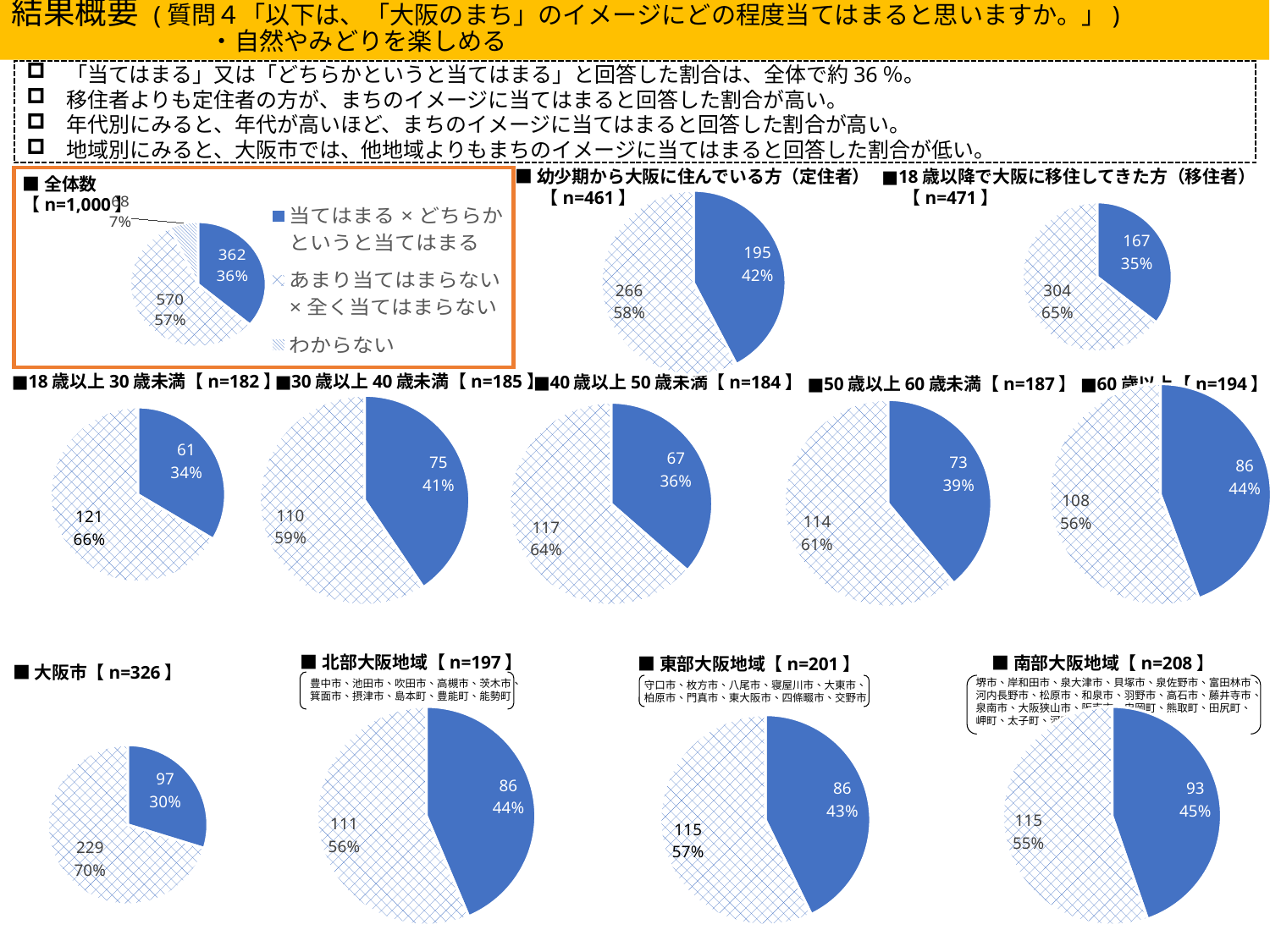
How many entries does the legend next to the 全体数 pie chart list? 3 In the 全体数 (n=1,000) pie chart, how many respondents answered あまり当てはまらない × 全く当てはまらない? 570 In the 幼少期から大阪に住んでいる方（定住者） pie chart, what share of respondents answered that the image applies (当てはまる)? 42% What is the difference in the 当てはまる percentage between the 南部大阪地域 chart (45%) and the 大阪市 chart (30%)? 15 percentage points In the 18歳以降で大阪に移住してきた方（移住者） pie chart, how many respondents answered that the image does not apply (あまり当てはまらない × 全く当てはまらない)? 304 In the 東部大阪地域 (n=201) pie chart, how many respondents answered 当てはまる × どちらかというと当てはまる? 86 In the 大阪市 (n=326) pie chart, what percentage of respondents answered that the image does not apply? 70% Among the five age-group pie charts, which age group has the lowest 当てはまる percentage? 18歳以上30歳未満 (34%) In the 全体数 (n=1,000) pie chart, what percentage of respondents answered 当てはまる × どちらかというと当てはまる? 36% What kind of chart is used throughout this slide? Pie chart Among the five age-group pie charts, which age group has the highest 当てはまる percentage? 60歳以上 (44%) Which is larger: the 当てはまる share for 定住者 (42%) or for 移住者 (35%)? 定住者 (42%)